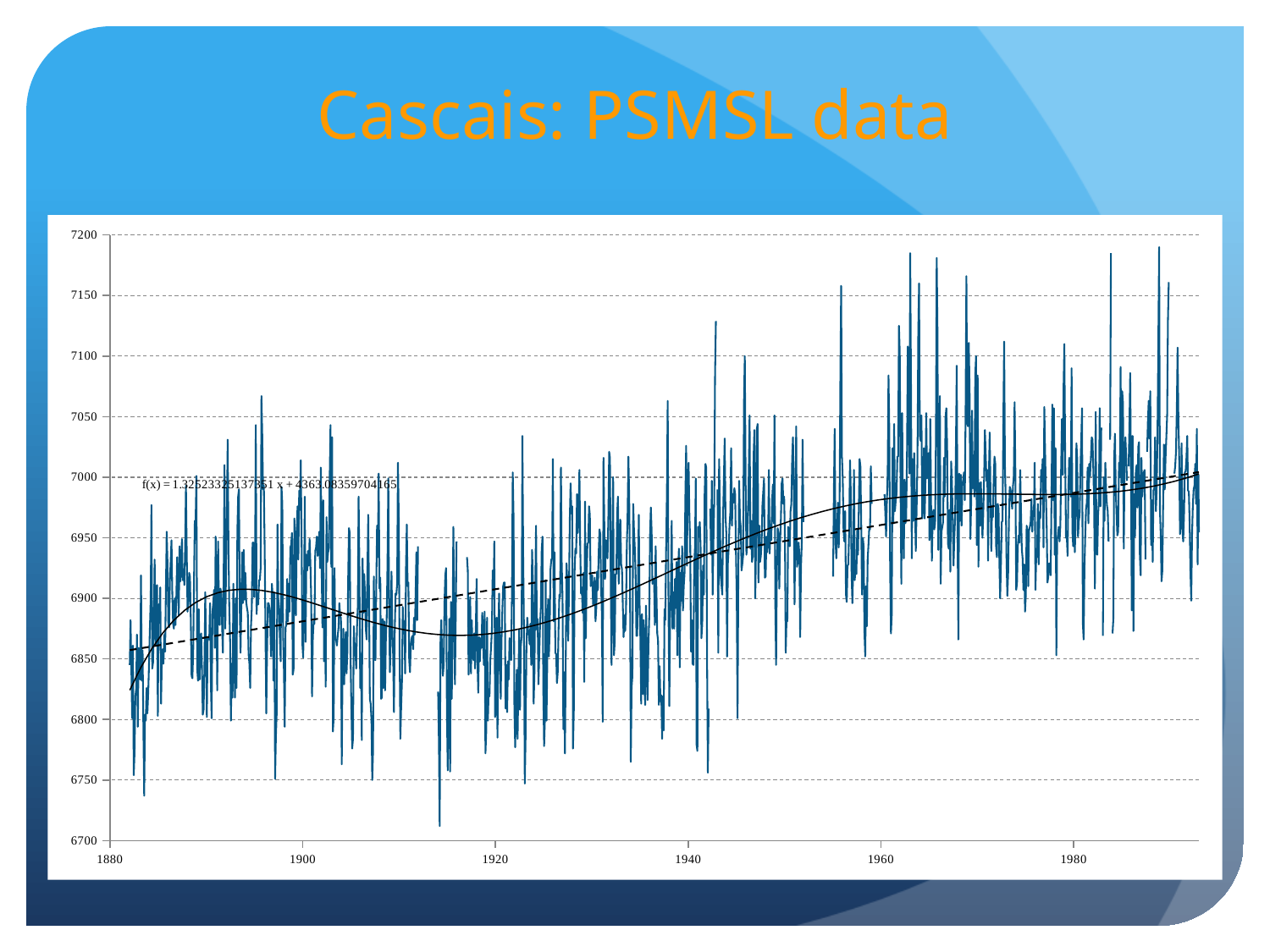
Is the solid smoothed trend curve higher around 1895 or around 1918? 1895 Is the solid smoothed trend curve around 1920 greater or less than 6900? less Is the dashed linear trend line at 1880 greater or less than 6900? less Is the dashed linear trend line higher at 1880 or at 1980? 1980 What kind of chart is shown on the slide? line chart Is the solid smoothed trend curve around 1960 greater or less than 6950? greater Do the plotted values generally rise or fall from 1880 to 1990? rise What is the highest value labelled on the vertical axis? 7200 What is the title of the chart? Cascais: PSMSL data